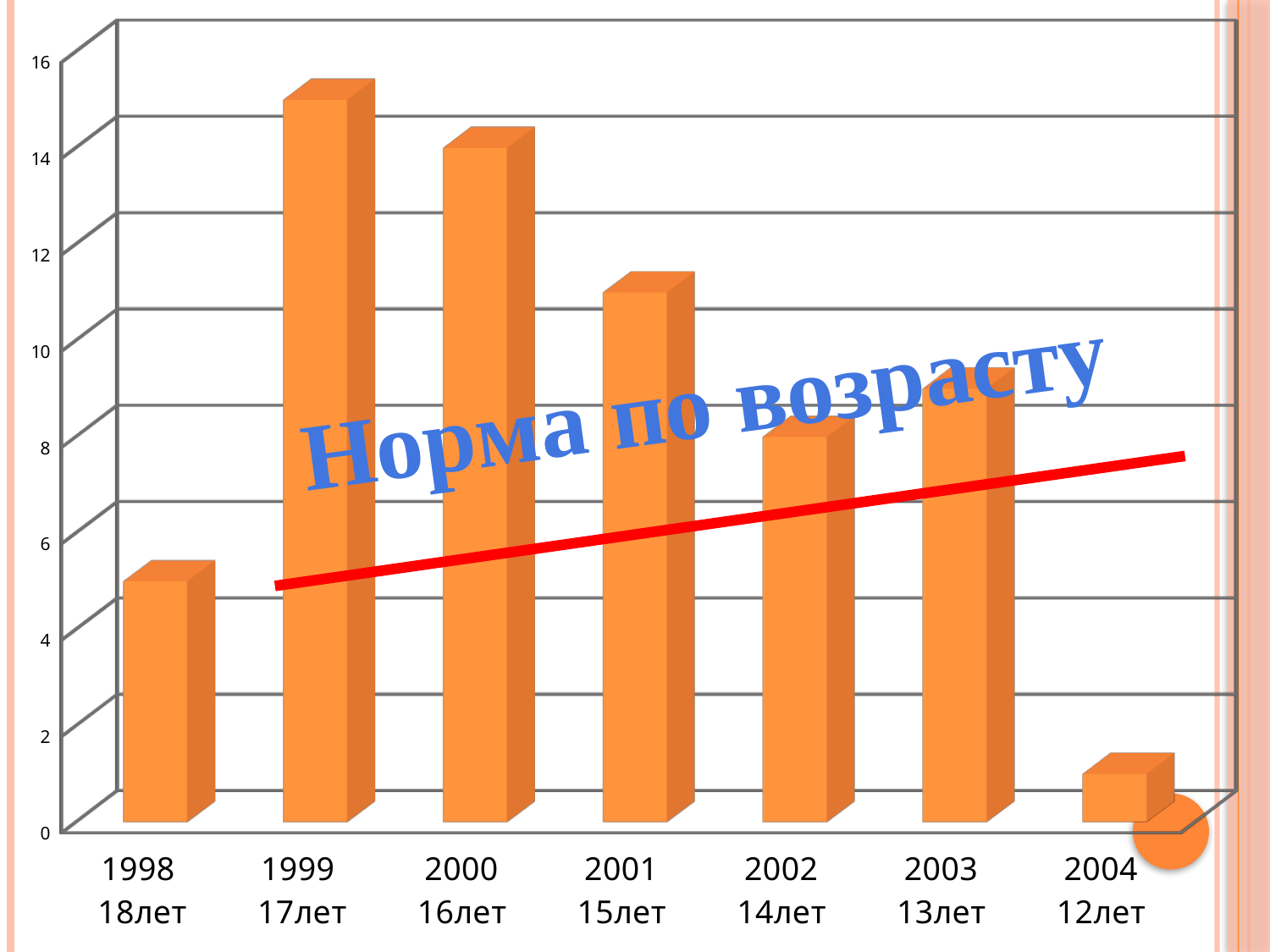
Do the values rise or fall from 1999 to 2002? fall Which year has the highest bar? 1999 (17лет) Which year has the lowest bar? 2004 (12лет) Which is larger, the value for 1999 or the value for 2000? 1999 Is the value for 2001 (15лет) greater or less than 10? greater Is the value for 2004 (12лет) greater or less than 2? less What kind of chart is shown on the slide? bar chart Is the value for 2002 (14лет) greater or less than 10? less What does the label on the red line across the chart say? Норма по возрасту How many categories (years) are shown on the x axis? 7